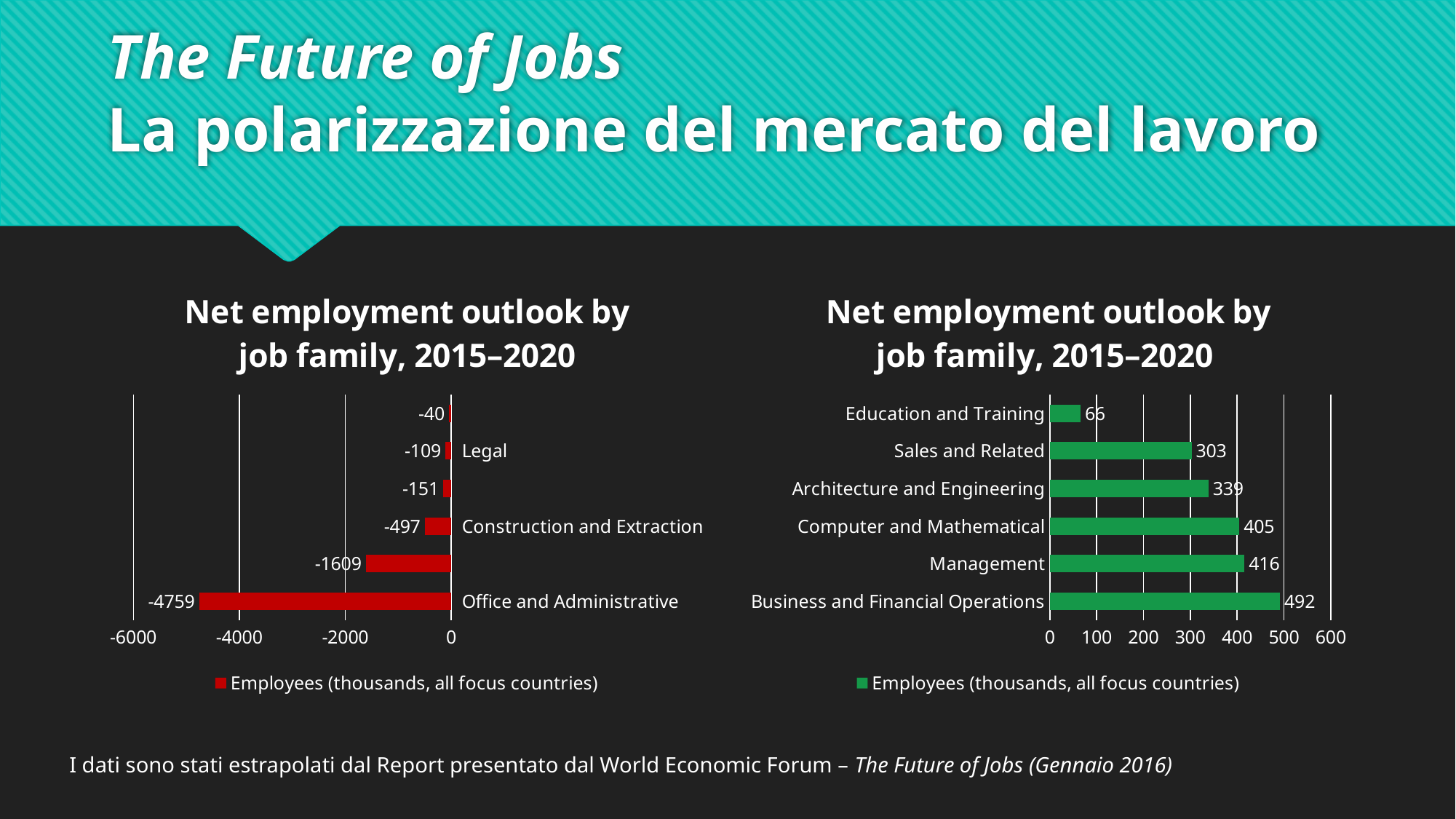
In the left-hand chart, what is the difference between the values for Office and Administrative and Construction and Extraction? 4262 How many job families are plotted in the right-hand chart? 6 In the right-hand chart, which job family has the highest value? Business and Financial Operations In the right-hand chart, which job family has the lowest value? Education and Training In the left-hand chart, what is the value for Construction and Extraction? -497 In the right-hand chart, which is larger: Architecture and Engineering or Sales and Related? Architecture and Engineering In the right-hand chart, what is the value for Computer and Mathematical? 405 How many bars are plotted in the left-hand chart? 6 In the right-hand chart, what is the difference between the values for Management and Sales and Related? 113 In the left-hand chart, what is the value for Office and Administrative? -4759 What type of chart is the right-hand chart? Bar chart In the left-hand chart, what is the value for Legal? -109